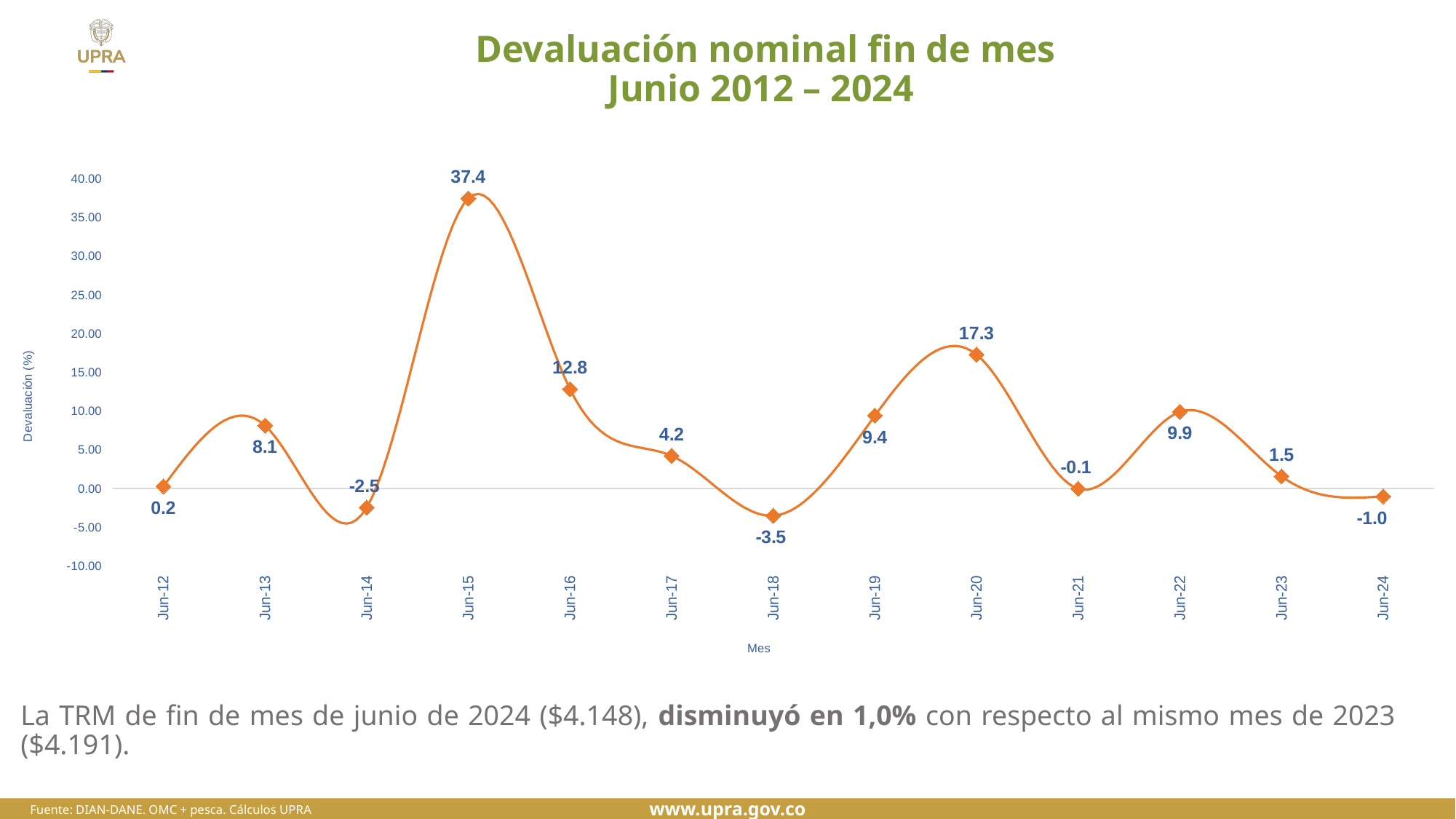
Is the value for Jun-15 greater or less than 35.00? greater What is the title of the chart? Devaluación nominal fin de mes Junio 2012 – 2024 What is the value for Jun-15? 37.4 What kind of chart is shown on the slide? line chart What is the difference between the values for Jun-15 and Jun-16? 24.6 Do the values rise or fall from Jun-22 to Jun-24? fall Which is larger, the value for Jun-20 or the value for Jun-22? Jun-20 How many data points are plotted on the chart? 13 What is the value for Jun-18? -3.5 What is the value for Jun-24? -1.0 Which month has the highest value? Jun-15 Which month has the lowest value? Jun-18